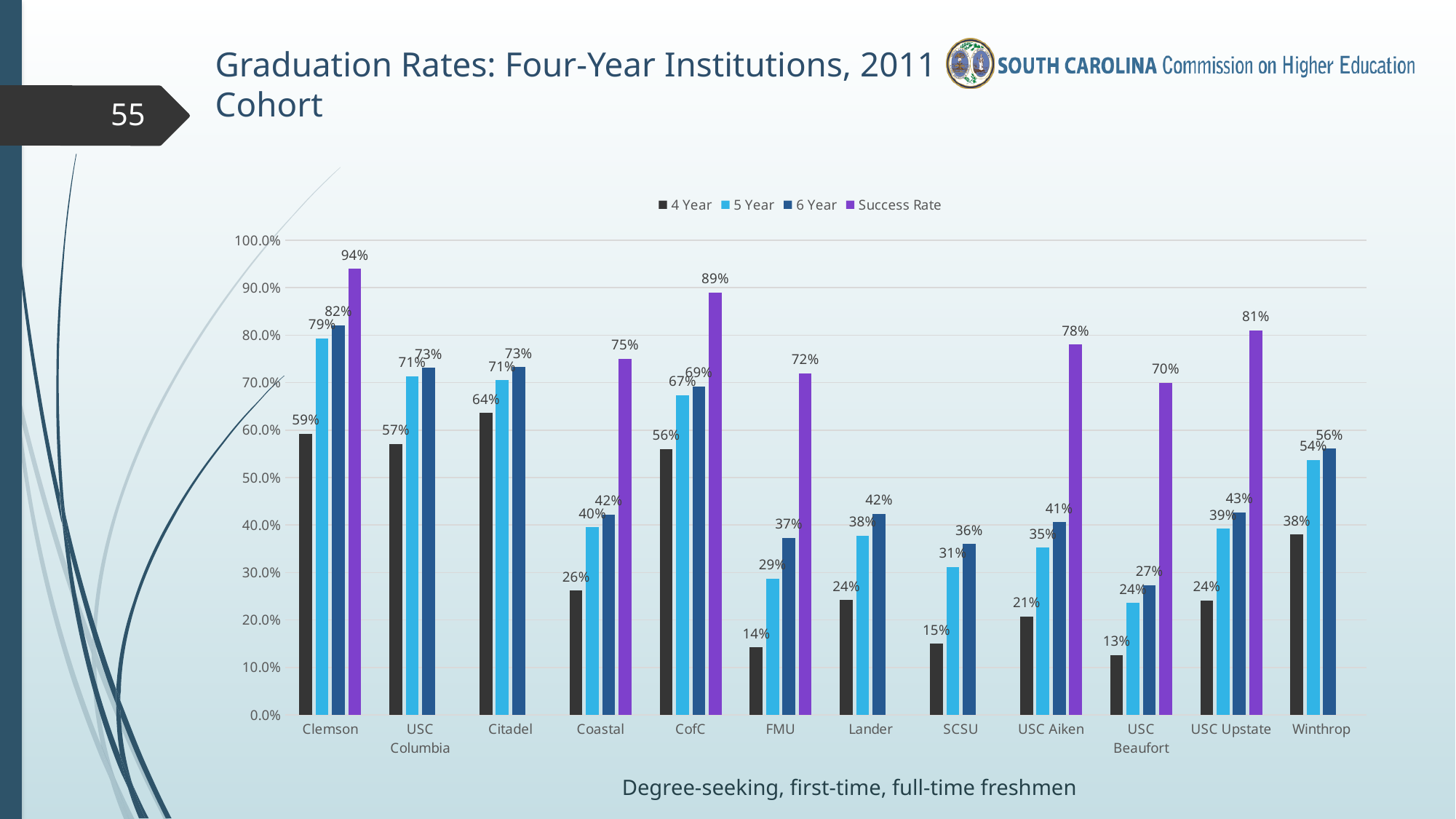
How many series does the legend list? 4 Is the 4 Year graduation rate for Coastal greater or less than 30.0%? less Which institution has the lowest 4 Year graduation rate? USC Beaufort What are the four series listed in the legend? 4 Year, 5 Year, 6 Year, Success Rate What is the 6 Year graduation rate for Clemson? 82% What kind of chart is shown on the slide? bar chart Which institution has the highest Success Rate? Clemson How many institutions are shown on the x axis? 12 What is the 4 Year graduation rate for FMU? 14% Which has the higher 4 Year graduation rate, Citadel or USC Columbia? Citadel What is the difference between Clemson's 6 Year rate and its 4 Year rate? 23 percentage points What is the Success Rate for USC Upstate? 81%